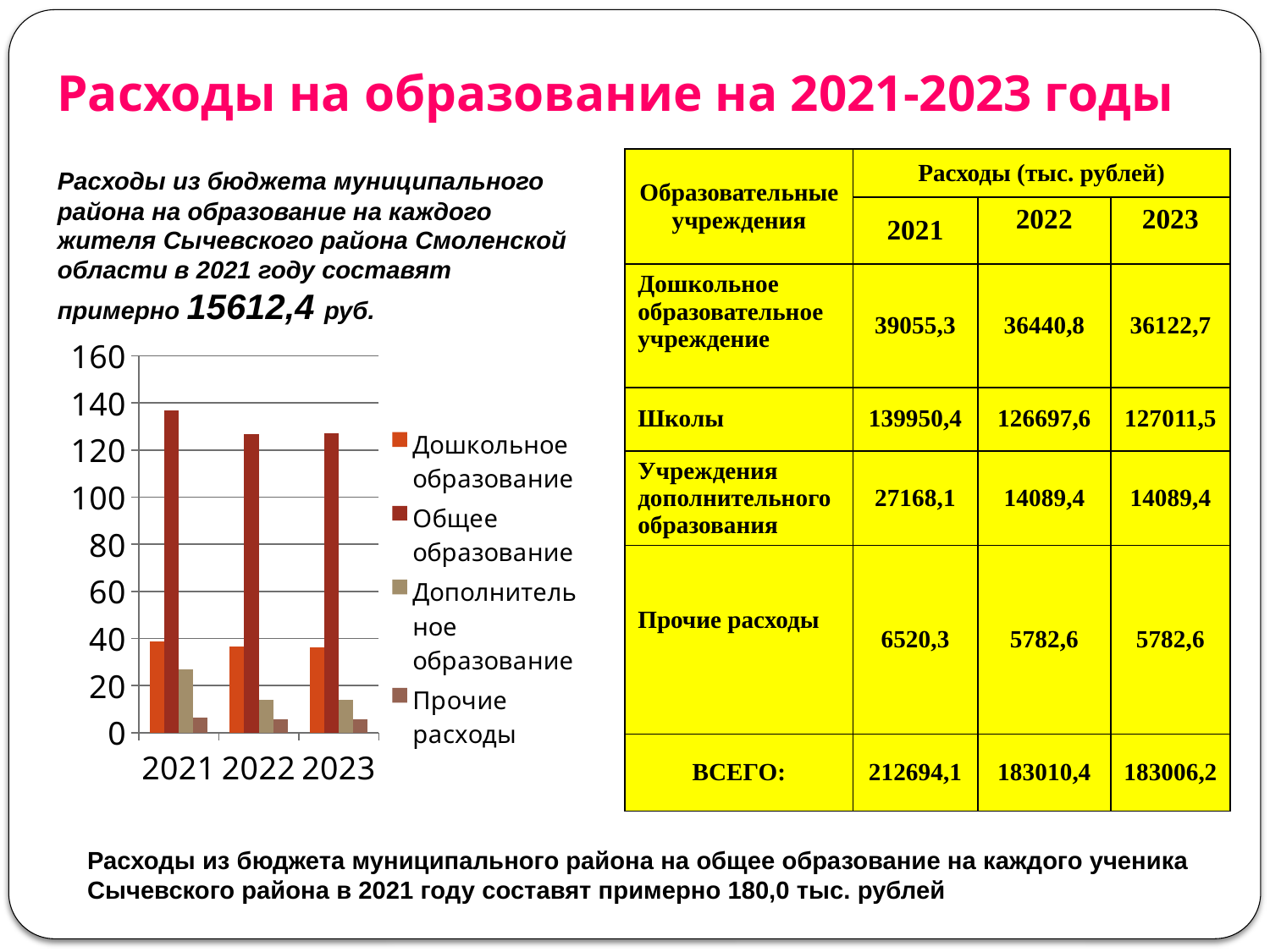
Does the value for Дополнительное образование rise or fall from 2021 to 2022? Fall Is the value for Дополнительное образование in 2023 greater or less than 20? less How many series does the chart legend list? 4 Is the value for Дошкольное образование in 2022 greater or less than 60? less How many years (categories) are shown on the x axis of the chart? 3 What is the highest value shown on the chart's vertical axis? 160 Is the value for Общее образование in 2021 greater or less than 120? greater Which series has the tallest bar in 2021? Общее образование Which is larger: Общее образование in 2021 or Общее образование in 2022? 2021 What kind of chart is shown on the slide? Bar chart Which series has the shortest bar in 2023? Прочие расходы